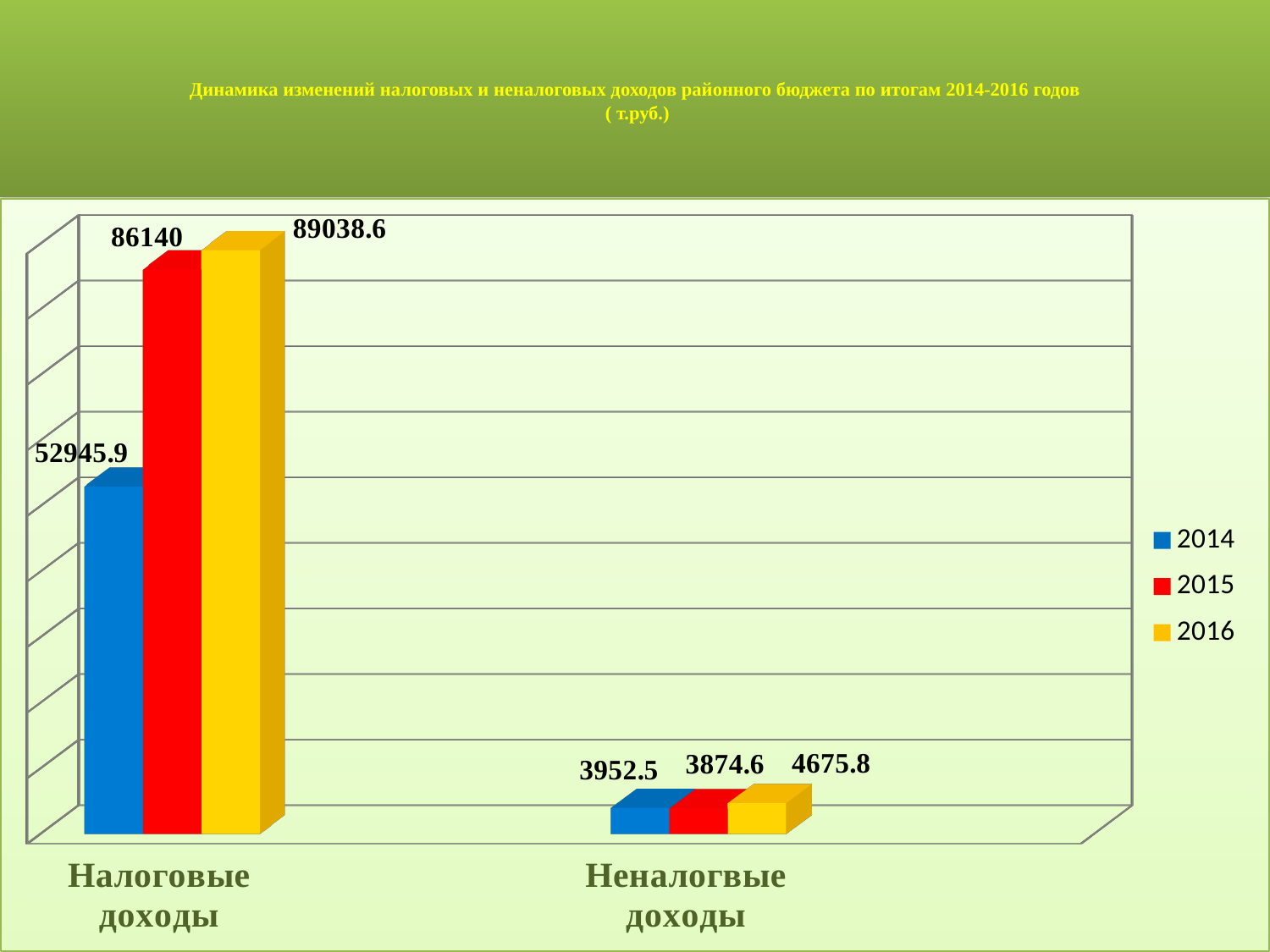
Which is larger: the 2014 value or the 2015 value in the Налоговые доходы category? 2015 What colour represents the 2015 series in the legend? Red What kind of chart is shown on the slide? Bar chart Which year has the highest value in the Налоговые доходы category? 2016 What is the value for 2016 in the Неналогвые доходы category? 4675.8 How many series does the legend list? 3 What is the difference between the 2016 and 2015 values in the Налоговые доходы category? 2898.6 What is the value for 2015 in the Налоговые доходы category? 86140 What is the value for 2014 in the Налоговые доходы category? 52945.9 What is the value for 2014 in the Неналогвые доходы category? 3952.5 Which year has the lowest value in the Неналогвые доходы category? 2015 What is the value for 2016 in the Налоговые доходы category? 89038.6